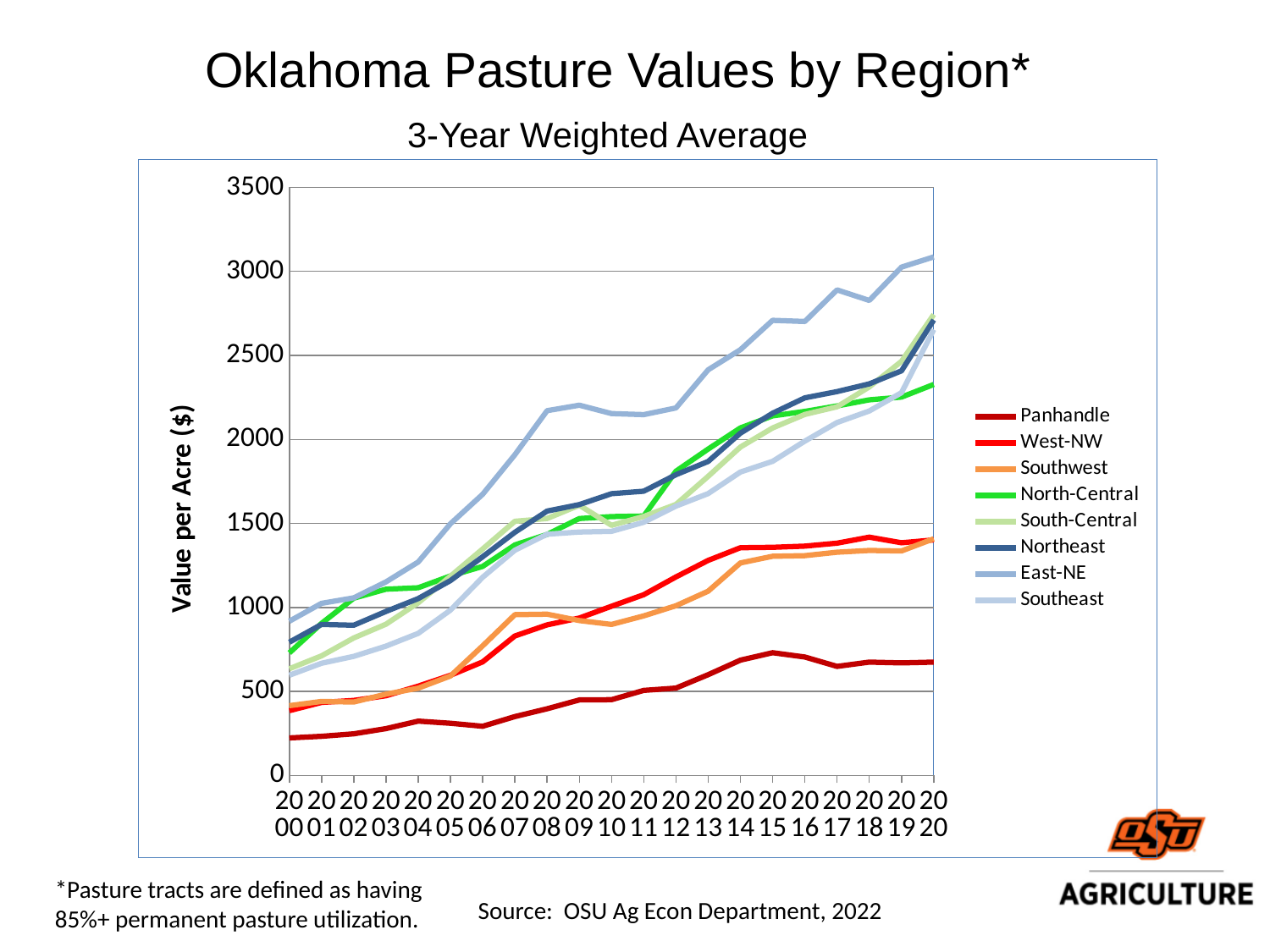
Which is larger in 2010, the value for East-NE or the value for Southeast? East-NE Is the value for West-NW in 2020 greater or less than 1500? less How many series does the legend list? 8 Which region has the lowest pasture value in 2020? Panhandle Is the value for East-NE in 2020 greater or less than 3000? greater What is the label on the y axis of the chart? Value per Acre ($) Is the value for Panhandle in 2000 greater or less than 500? less Which region has the highest pasture value in 2020? East-NE How many years are plotted along the x axis? 21 Do the Panhandle pasture values generally rise or fall from 2000 to 2020? rise What kind of chart is shown on the slide? line chart